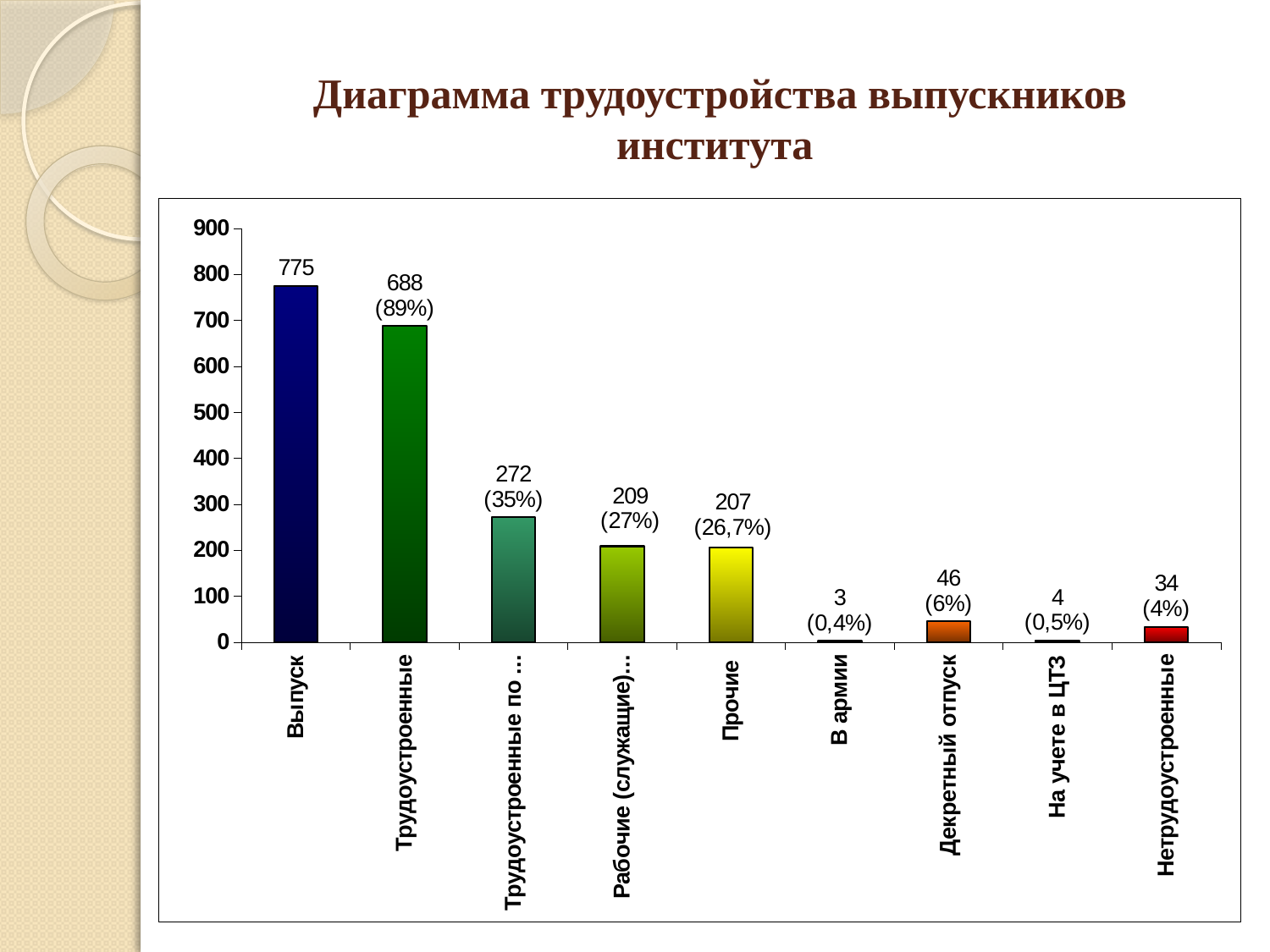
What is the value for Выпуск? 775 What is the value for Трудоустроенные? 688 Which category has the highest value? Выпуск How many categories are shown on the x axis? 9 Which is larger, the value for Декретный отпуск or the value for Нетрудоустроенные? Декретный отпуск What is the value for Нетрудоустроенные? 34 What is the difference between the values for Выпуск and Трудоустроенные? 87 What kind of chart is shown on the slide? bar chart Which category has the lowest value? В армии What is the value for Декретный отпуск? 46 What is the value for Прочие? 207 What percentage is shown for Трудоустроенные? 89%